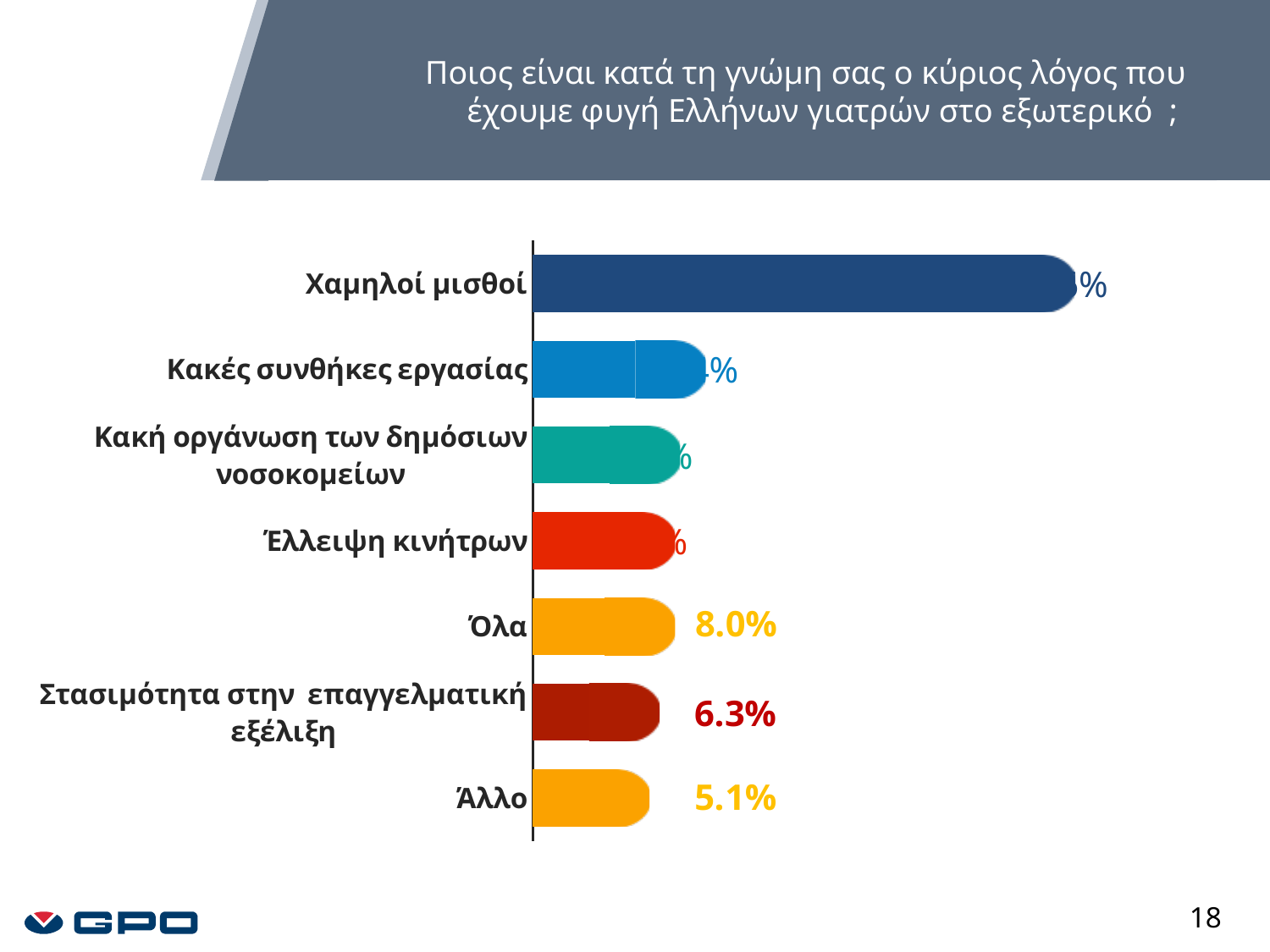
What is the value for Όλα? 8.0% Which reason has the lowest value in the chart? Άλλο What is the value for Άλλο? 5.1% What kind of chart is shown on the slide? Bar chart What is the difference between the values for Όλα and Άλλο? 2.9% Which reason has the highest value in the chart? Χαμηλοί μισθοί How many categories (reasons) are plotted in the chart? 7 What is the difference between the values for Στασιμότητα στην επαγγελματική εξέλιξη and Άλλο? 1.2% What colour is the bar for Χαμηλοί μισθοί? Dark blue Do the bar values increase or decrease going from the top category to the bottom category? Decrease Which is larger: the value for Χαμηλοί μισθοί or the value for Κακές συνθήκες εργασίας? Χαμηλοί μισθοί What is the value for Στασιμότητα στην επαγγελματική εξέλιξη? 6.3%